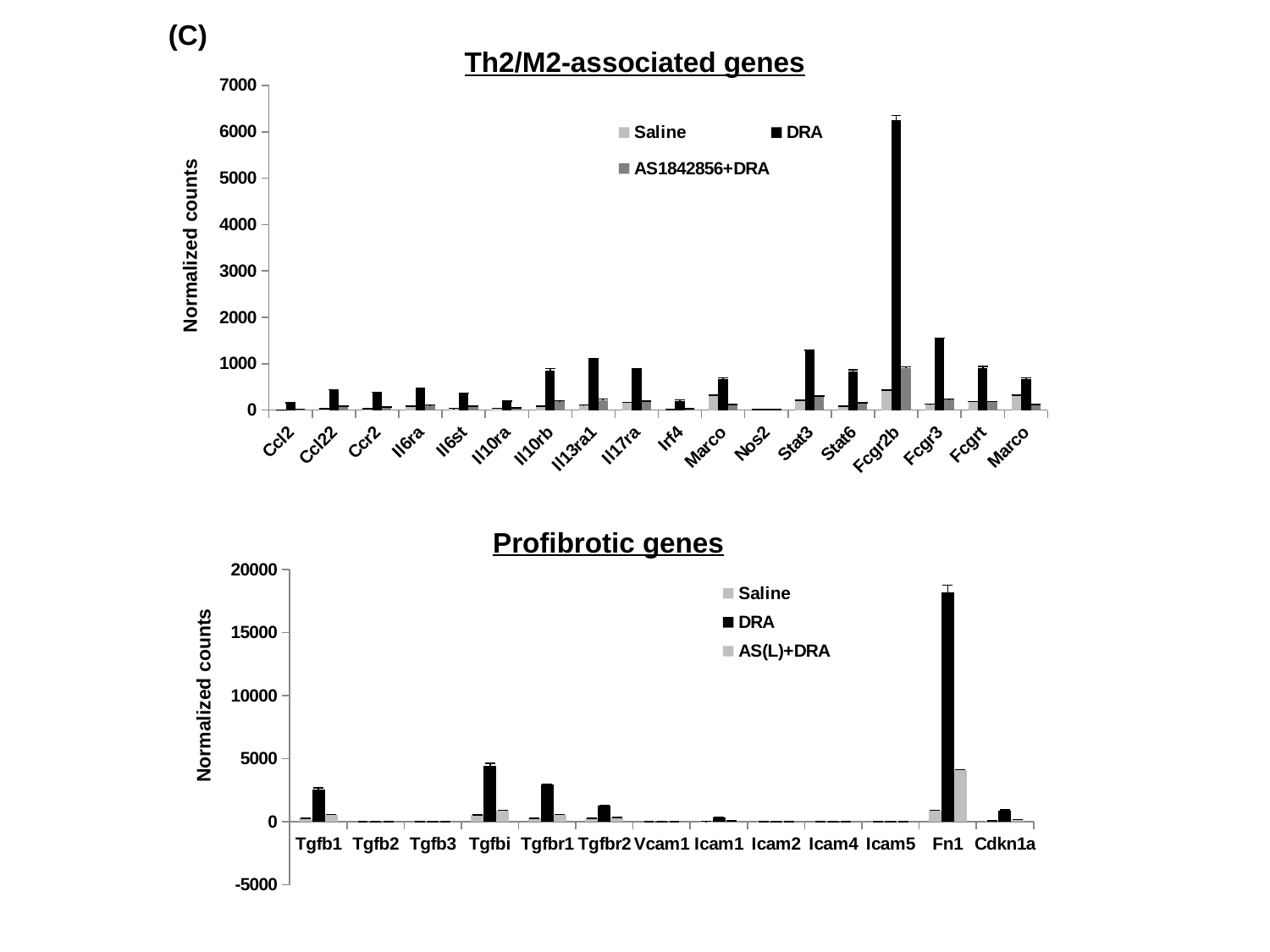
On the Profibrotic genes chart, which is larger, the DRA value for Tgfbi or the DRA value for Tgfbr1? Tgfbi What kind of chart is the Profibrotic genes chart? bar chart On the Th2/M2-associated genes chart, how many genes are shown on the x axis? 18 On the Profibrotic genes chart, is the DRA value for Fn1 greater or less than 15000? greater On the Th2/M2-associated genes chart, how many series does the legend list? 3 On the Profibrotic genes chart, how many genes are shown on the x axis? 13 On the Th2/M2-associated genes chart, is the DRA value for Ccl22 greater or less than 1000? less On the Profibrotic genes chart, which gene has the highest DRA value? Fn1 On the Th2/M2-associated genes chart, which is larger, the DRA value for Fcgr3 or the DRA value for Il10rb? Fcgr3 On the Profibrotic genes chart, what is the label of the y axis? Normalized counts On the Th2/M2-associated genes chart, which gene has the highest DRA value? Fcgr2b On the Th2/M2-associated genes chart, is the DRA value for Fcgr2b greater or less than 6000? greater